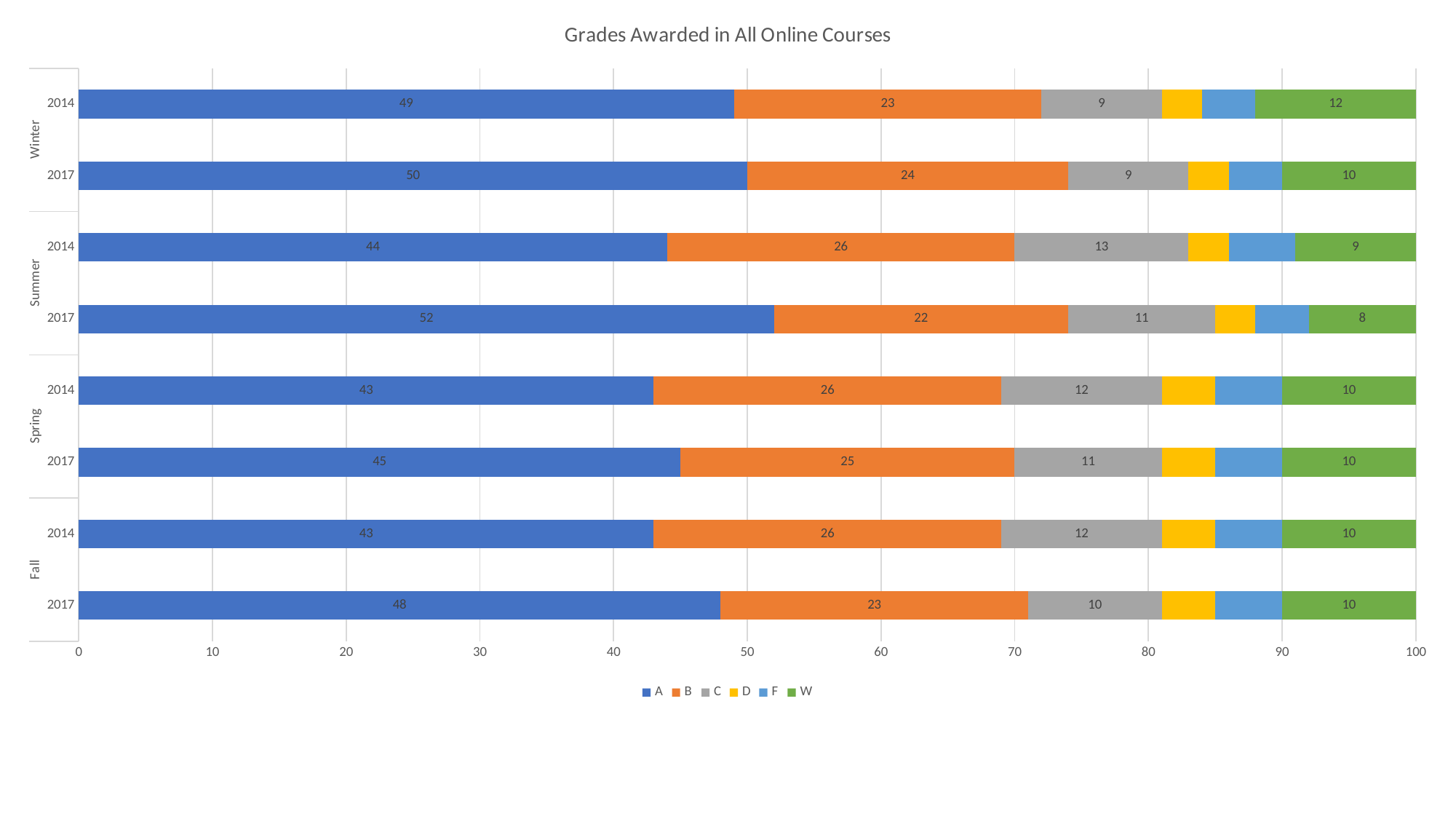
How many series does the legend list? 6 How many bars are shown in the chart? 8 What is the value for grade W in Winter 2014? 12 What is the value for grade C in Summer 2014? 13 What is the difference between the grade A values for Winter 2017 and Winter 2014? 1 Which has the larger grade A value, Fall 2017 or Fall 2014? Fall 2017 What is the title of the chart? Grades Awarded in All Online Courses What is the value for grade A in Summer 2017? 52 What is the value for grade B in Winter 2017? 24 Which term has the lowest value for grade W? Summer 2017 Which term has the highest value for grade A? Summer 2017 What is the difference between the grade B values for Summer 2014 and Summer 2017? 4